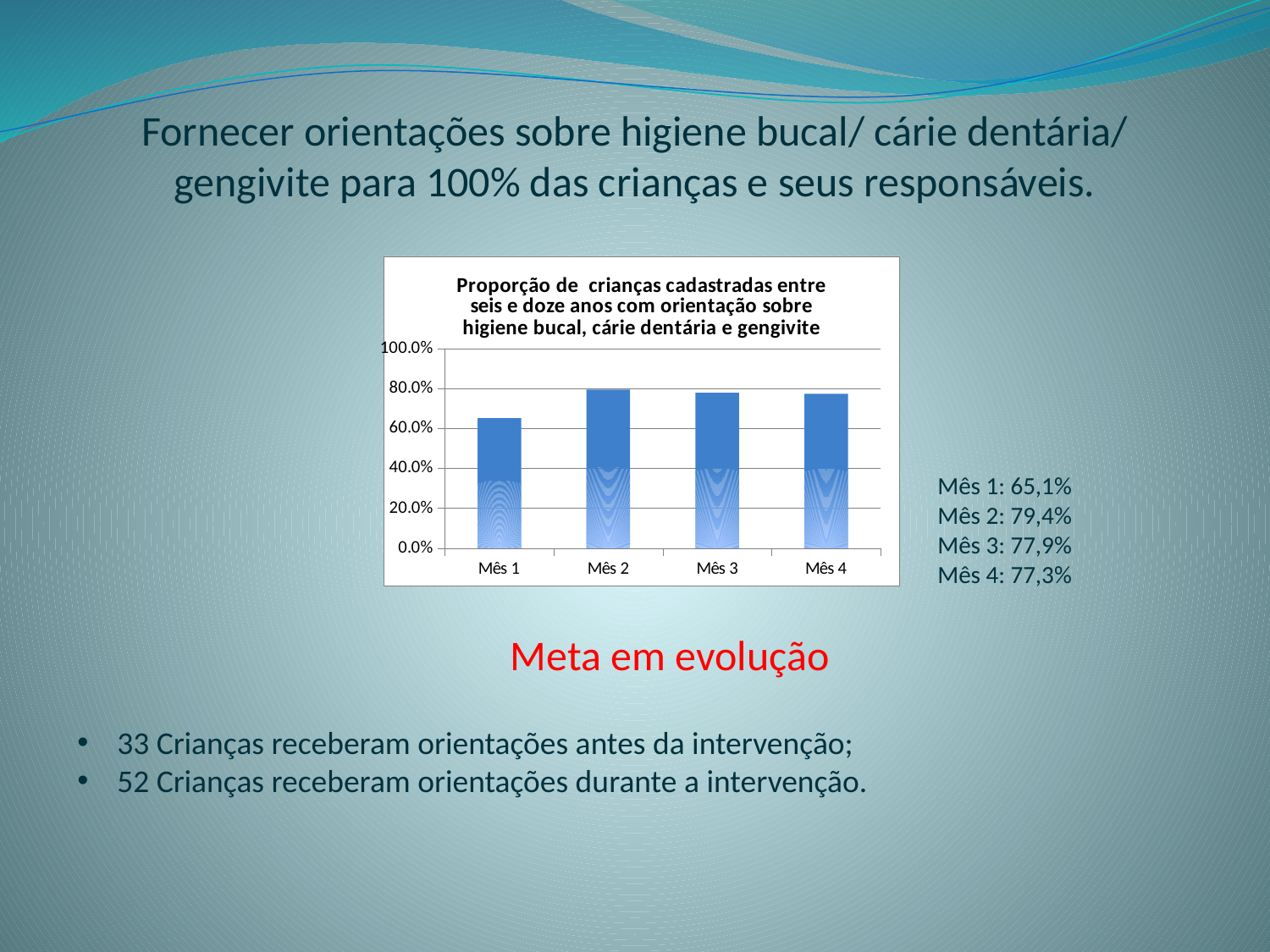
How many months (categories) are plotted in the chart? 4 Which month has the lowest proportion? Mês 1 What kind of chart is shown on the slide? Bar chart Which is larger, the value for Mês 1 or the value for Mês 4? Mês 4 What is the value for Mês 3? 77,9% Which month has the highest proportion? Mês 2 What is the highest value shown on the vertical axis of the chart? 100.0% Is the value for Mês 1 greater or less than 60.0%? greater What is the difference between the values for Mês 2 and Mês 1? 14,3% What is the value for Mês 2? 79,4% What is the value for Mês 4? 77,3% What is the value for Mês 1? 65,1%